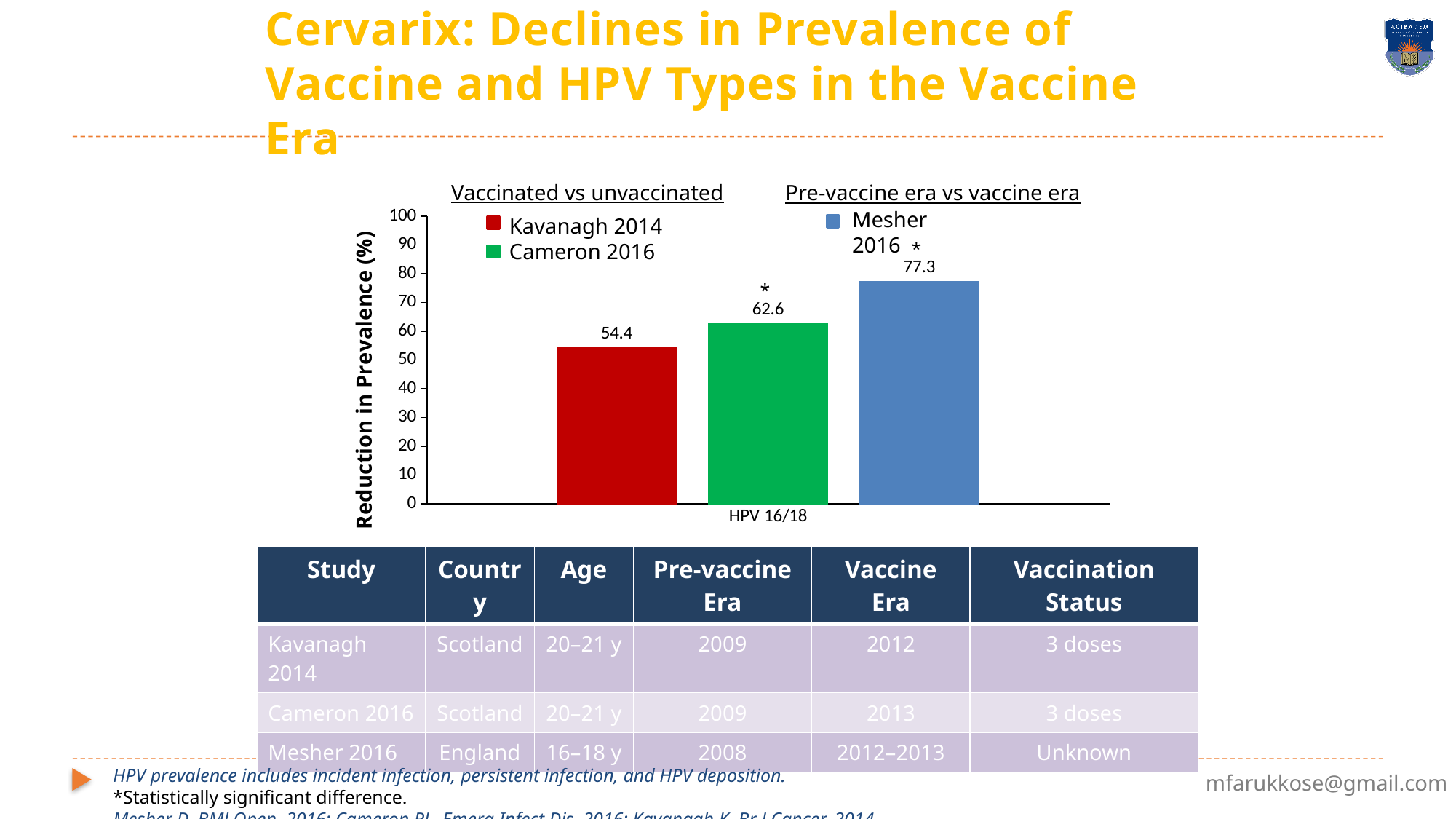
Which is larger, the value for Cameron 2016 or the value for Kavanagh 2014? Cameron 2016 What is the reduction in prevalence for Mesher 2016? 77.3 What is the label of the y axis of the chart? Reduction in Prevalence (%) Is the value for Mesher 2016 greater or less than 70? greater What is the difference between the Cameron 2016 and Kavanagh 2014 values? 8.2 What is the difference between the Mesher 2016 and Kavanagh 2014 values? 22.9 Which study shows the highest reduction in prevalence? Mesher 2016 What kind of chart is shown on the slide? Bar chart What is the reduction in prevalence for Cameron 2016? 62.6 How many series does the chart's legend list? 3 What is the reduction in prevalence for Kavanagh 2014? 54.4 Which study shows the lowest reduction in prevalence? Kavanagh 2014